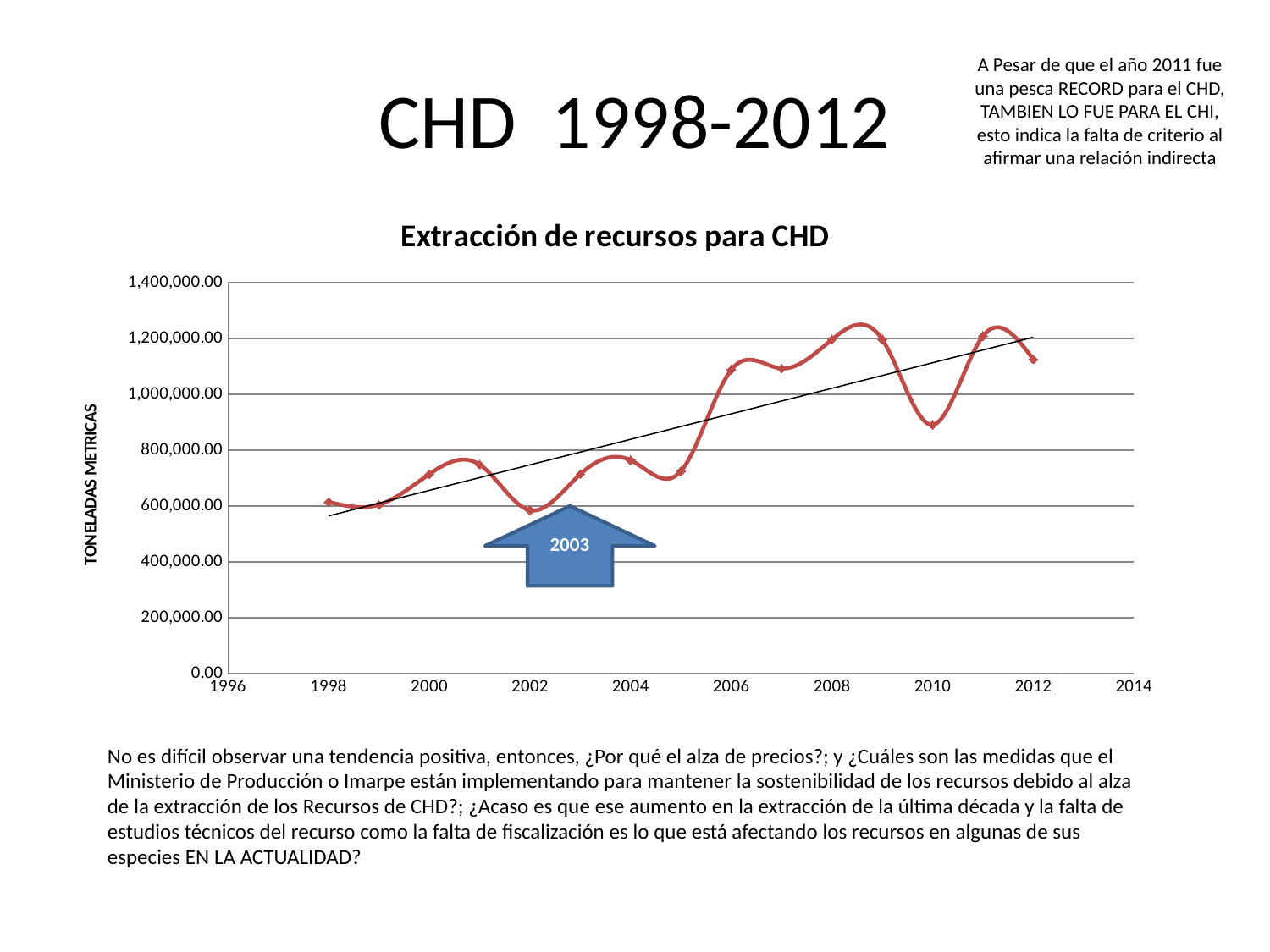
What is the label on the vertical axis of the chart? TONELADAS METRICAS Which year has the larger value, 2002 or 2010? 2010 Is the value for 2010 greater or less than 1,000,000.00? less What is the title of the chart? Extracción de recursos para CHD What kind of chart is shown on the slide? Line chart Is the value for 2012 greater or less than 1,000,000.00? greater Is the value for 2008 greater or less than 1,000,000.00? greater How many data points are plotted on the chart (years 1998 to 2012)? 15 Which year has the larger value, 2004 or 2006? 2006 Which year has the larger value, 2008 or 2010? 2008 Overall, do the values rise or fall from 1998 to 2012? Rise